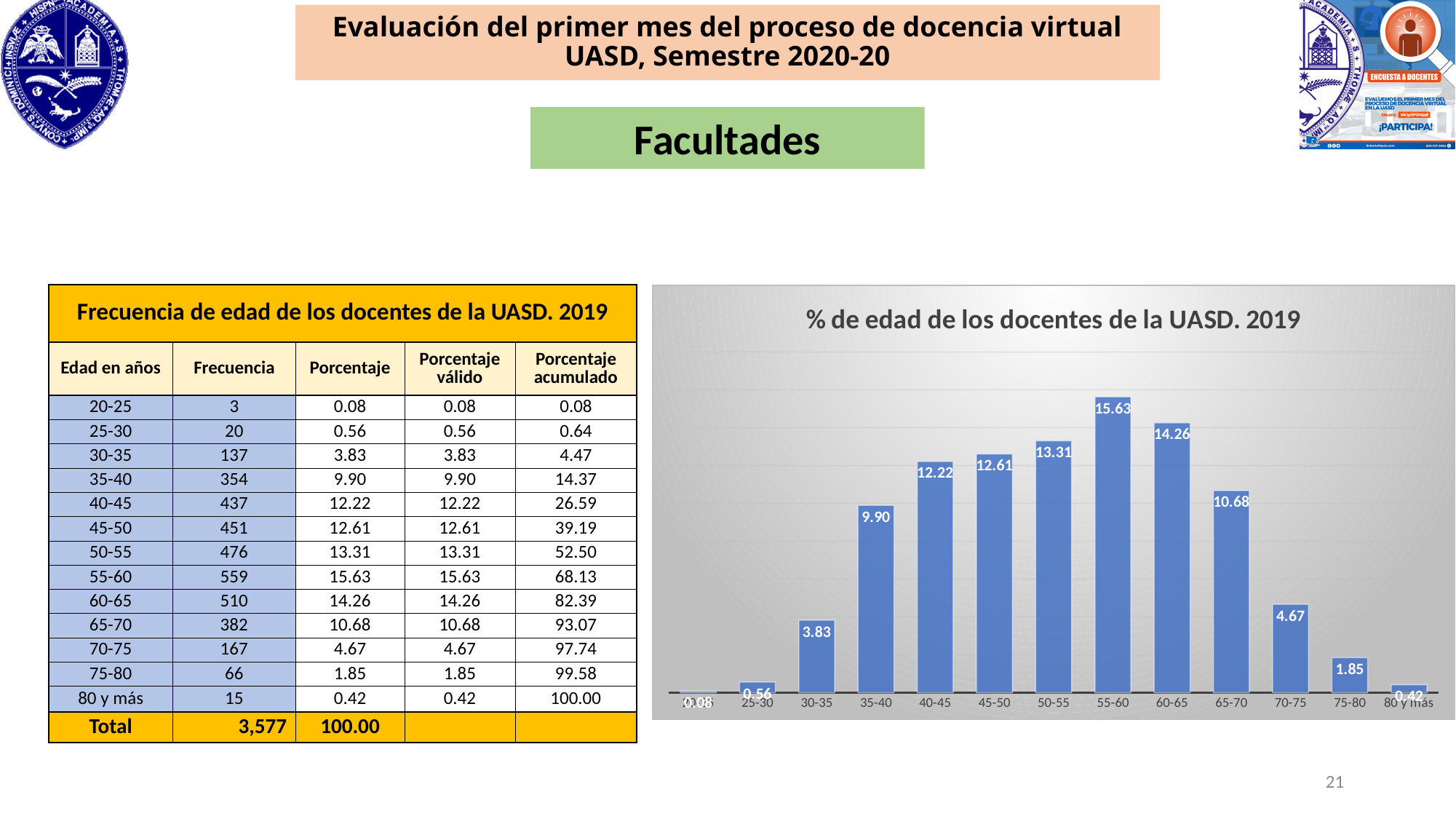
What is the value for the 40-45 age group in the chart? 12.22 What is the value for the 55-60 age group in the chart? 15.63 Which is larger, the value for 45-50 or the value for 50-55? 50-55 What is the difference between the values for 55-60 and 60-65? 1.37 What is the title of the chart? % de edad de los docentes de la UASD. 2019 What is the value for the 70-75 age group in the chart? 4.67 Which is larger, the value for 30-35 or the value for 75-80? 30-35 What is the difference between the values for 65-70 and 70-75? 6.01 Which age group has the highest value in the chart? 55-60 Which age group has the lowest value in the chart? 20-25 How many age groups are shown on the x axis of the chart? 13 What kind of chart is shown on the slide? Bar chart